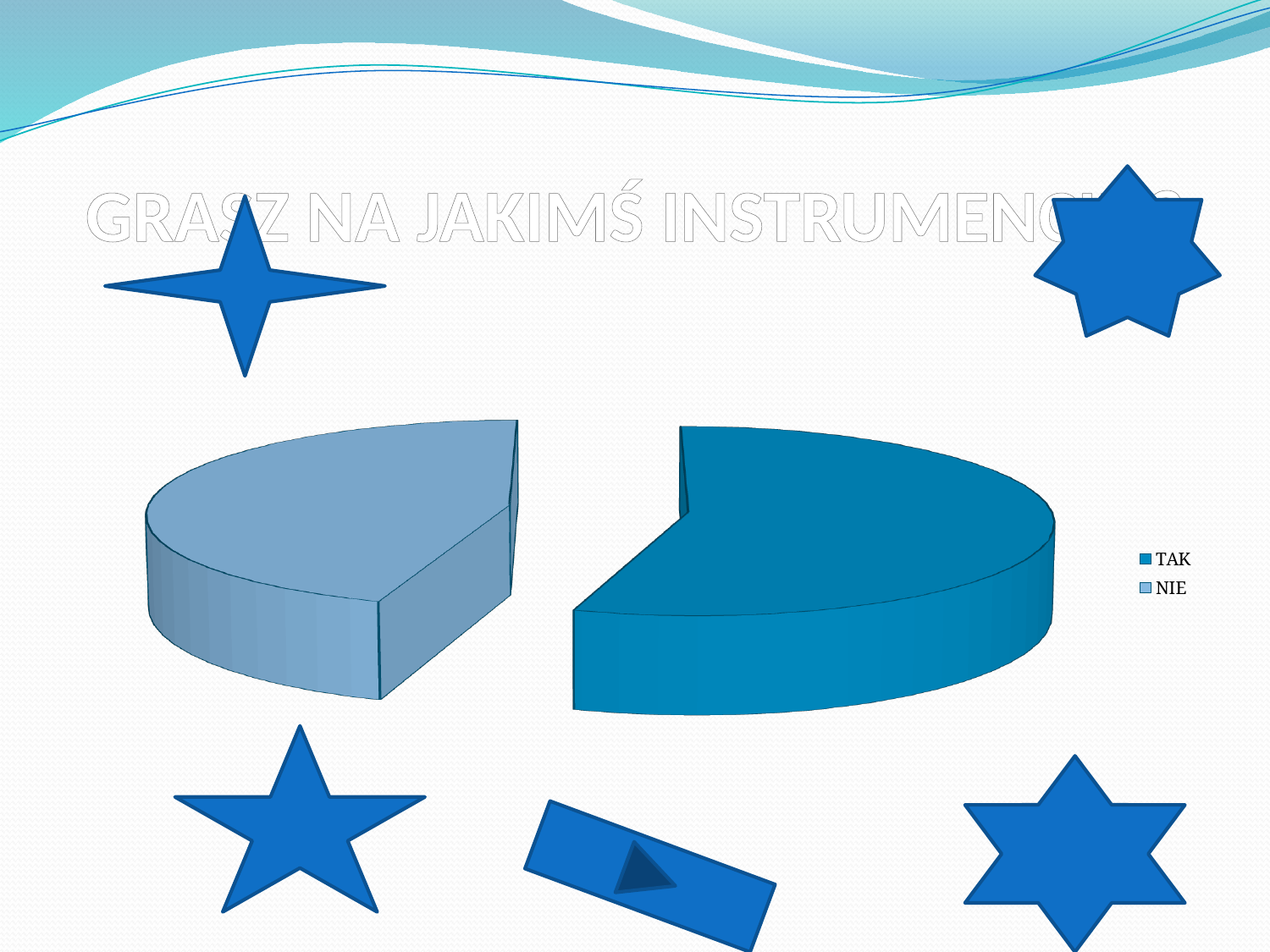
Which legend entry is shown in the lighter blue colour in the pie chart? NIE How many entries does the legend of the pie chart list? 2 Which category has the largest slice in the pie chart? TAK How many slices does the pie chart have? 2 Which slice is larger in the pie chart, TAK or NIE? TAK What kind of chart is shown on the slide? pie chart What are the two legend entries of the pie chart? TAK and NIE Which category has the smallest slice in the pie chart? NIE